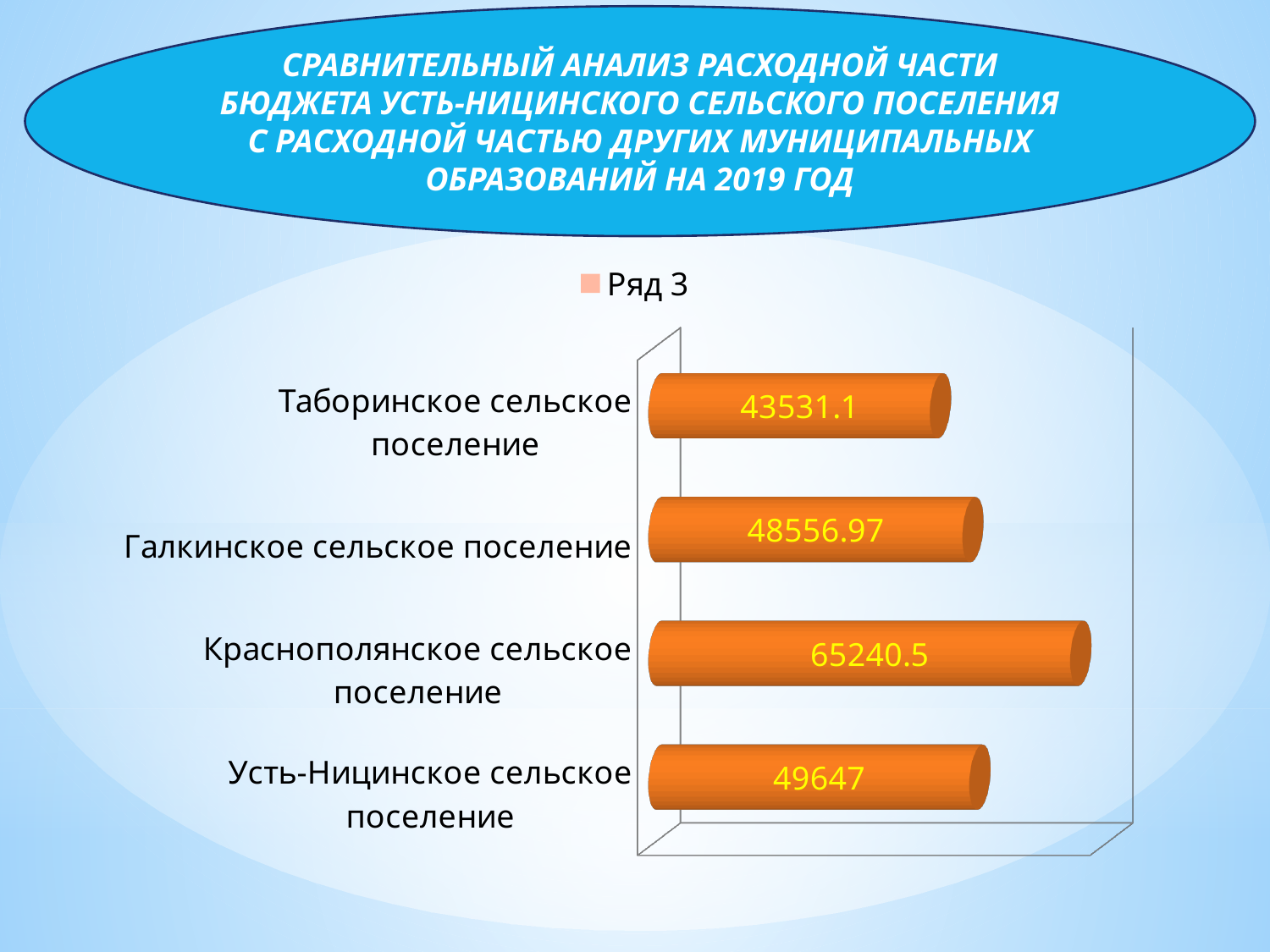
What is the value for Усть-Ницинское сельское поселение? 49647 How many series does the legend list? 1 What is the difference between the values for Краснополянское сельское поселение and Усть-Ницинское сельское поселение? 15593.5 Which category has the lowest value? Таборинское сельское поселение How many categories are shown in the chart? 4 What is the value for Галкинское сельское поселение? 48556.97 What is the value for Краснополянское сельское поселение? 65240.5 What is the value for Таборинское сельское поселение? 43531.1 What kind of chart is shown on the slide? Bar chart Which category has the highest value? Краснополянское сельское поселение Which is larger, the value for Усть-Ницинское сельское поселение or the value for Таборинское сельское поселение? Усть-Ницинское сельское поселение What is the difference between the values for Краснополянское сельское поселение and Таборинское сельское поселение? 21709.4